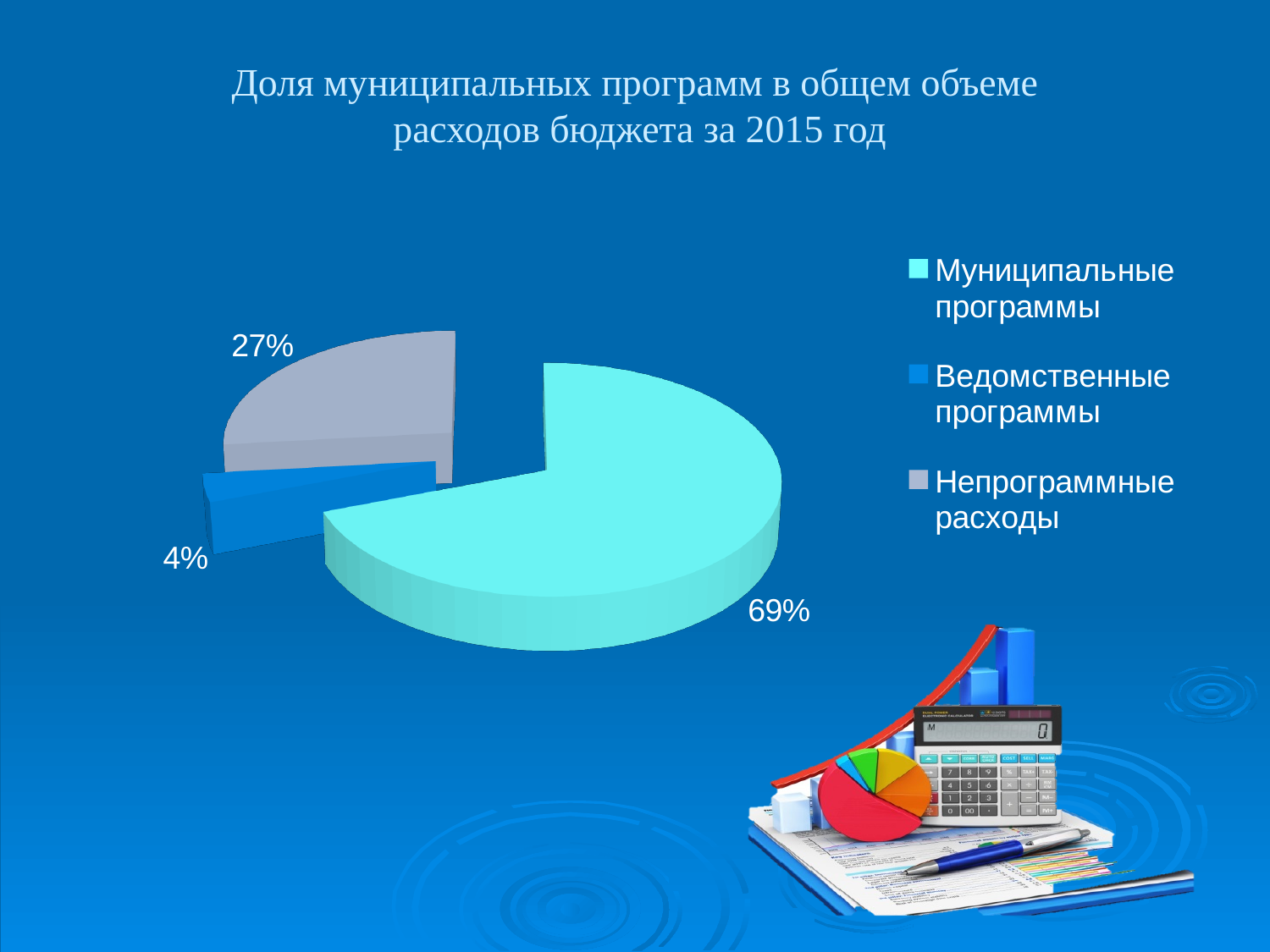
Which category has the largest slice of the pie? Муниципальные программы What share of the pie does Муниципальные программы have? 69% How many slices does the pie chart have? 3 What is the title of the chart on the slide? Доля муниципальных программ в общем объеме расходов бюджета за 2015 год What share of the pie does Ведомственные программы have? 4% How many entries does the legend list? 3 Which category has the smallest slice of the pie? Ведомственные программы What is the combined share of Ведомственные программы and Непрограммные расходы? 31% Which is larger: the share for Непрограммные расходы or the share for Ведомственные программы? Непрограммные расходы What kind of chart is shown on the slide? Pie chart What is the difference in percentage points between Муниципальные программы and Непрограммные расходы? 42 What share of the pie does Непрограммные расходы have? 27%